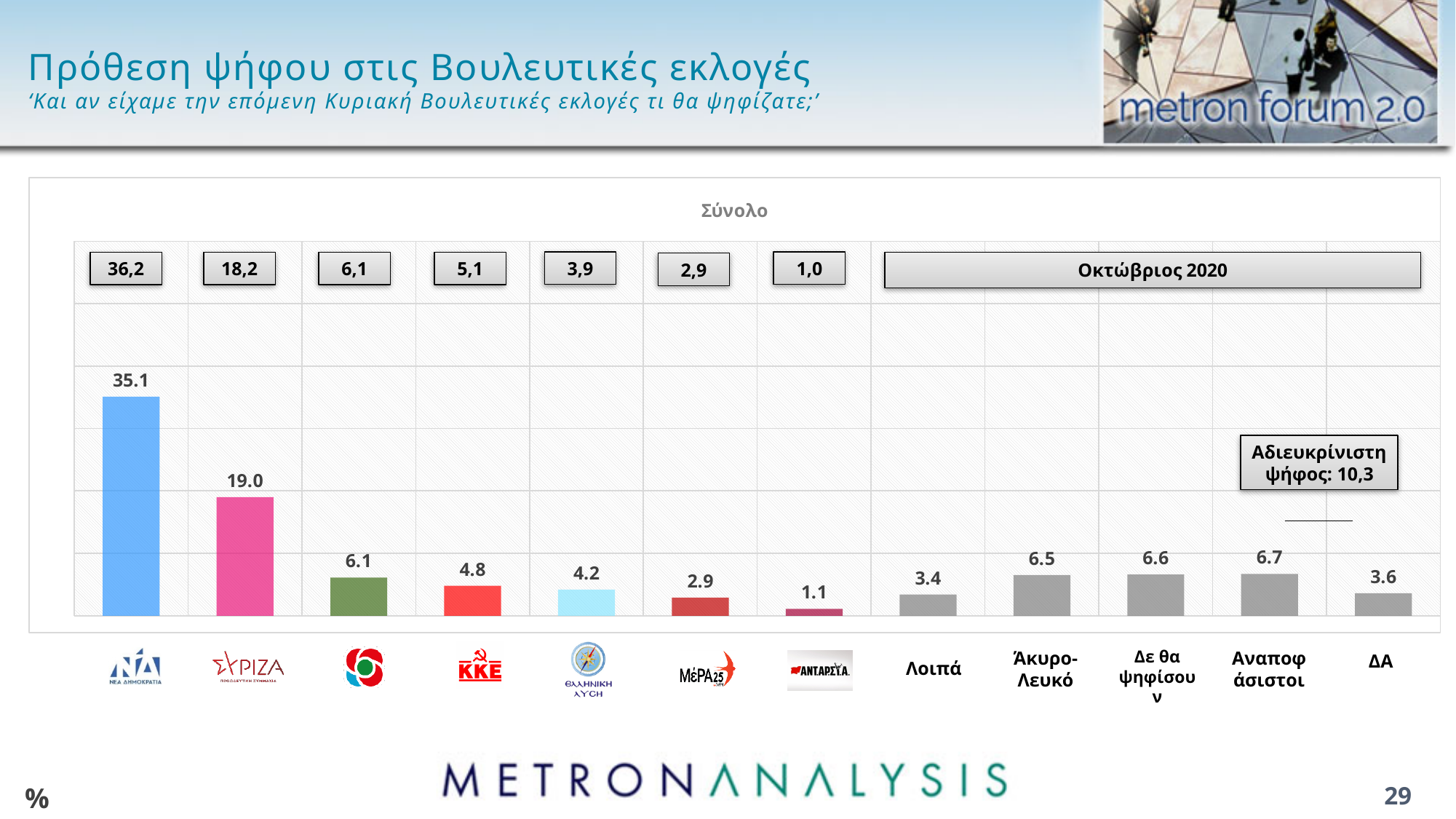
What is the value of the bar for ΝΔ (Νέα Δημοκρατία)? 35.1 Which category has the highest bar in the chart? ΝΔ (Νέα Δημοκρατία) How many bars are plotted in the chart? 12 What is the value of the bar for ΣΥΡΙΖΑ? 19.0 What is the value of the bar for ΚΚΕ? 4.8 What is the title shown above the chart? Σύνολο What type of chart is shown on the slide? bar chart Which is larger, the value for Ελληνική Λύση or the value for ΜέΡΑ25? Ελληνική Λύση What is the value of the bar for ΔΑ? 3.6 Which category has the lowest bar in the chart? ΑΝΤΑΡΣΥΑ What is the difference between the values for ΝΔ and ΣΥΡΙΖΑ? 16.1 What is the value of the bar for Αναποφάσιστοι? 6.7